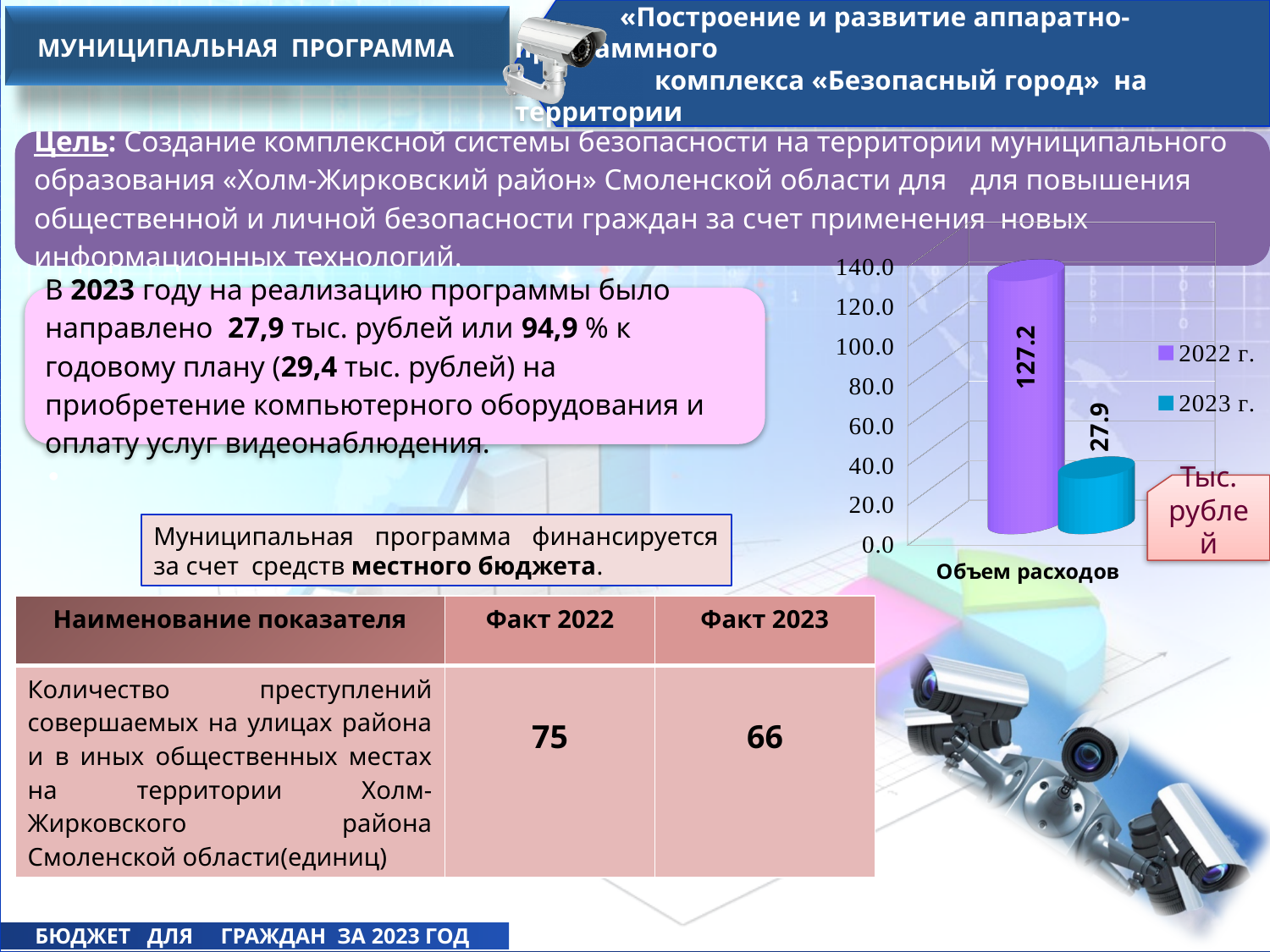
What is the category label shown below the chart's bars? Объем расходов Which series has the highest value in the chart? 2022 г. What is the difference between the 2022 г. and 2023 г. values in the chart? 99.3 Which series has the higher value, 2022 г. or 2023 г.? 2022 г. Is the value for 2023 г. greater or less than 40.0? less What is the value for 2022 г. in the chart? 127.2 How many series does the chart legend list? 2 What is the value for 2023 г. in the chart? 27.9 What type of chart is shown on the slide? bar chart Is the value for 2022 г. greater or less than 120.0? greater Which series has the lowest value in the chart? 2023 г. What is the highest value shown on the chart's vertical axis? 140.0